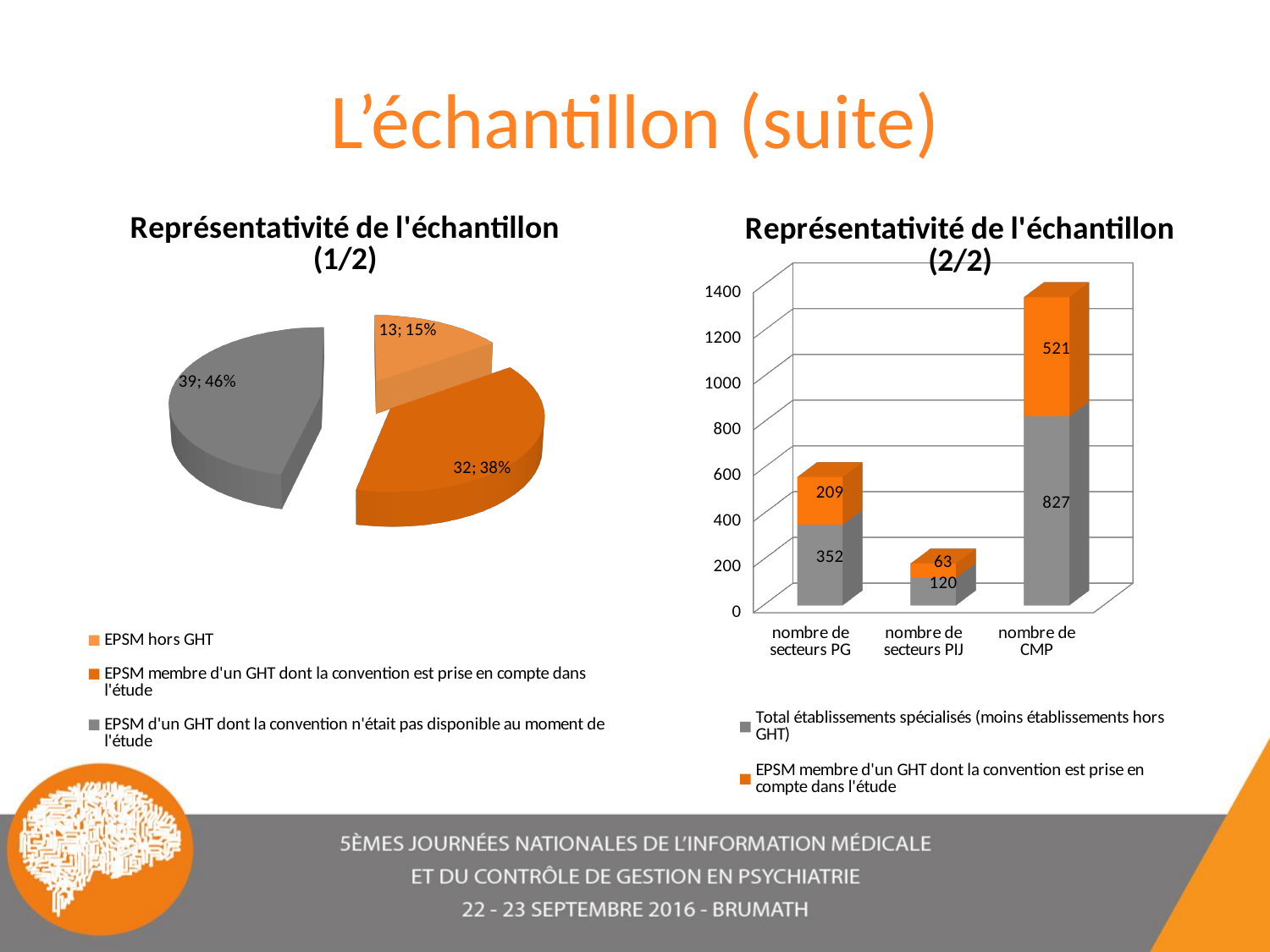
In the chart 'Représentativité de l'échantillon (1/2)', what share of the pie does the 'EPSM d'un GHT dont la convention n'était pas disponible au moment de l'étude' slice represent? 46% How many series does the legend of the chart 'Représentativité de l'échantillon (2/2)' list? 2 In the chart 'Représentativité de l'échantillon (2/2)', what is the value of 'Total établissements spécialisés (moins établissements hors GHT)' for 'nombre de secteurs PIJ'? 120 What kind of chart is 'Représentativité de l'échantillon (2/2)'? Stacked bar chart In the chart 'Représentativité de l'échantillon (1/2)', which category has the smallest slice? EPSM hors GHT In the chart 'Représentativité de l'échantillon (2/2)', what is the difference between the 'Total établissements spécialisés' value and the 'EPSM membre d'un GHT' value for 'nombre de CMP'? 306 In the chart 'Représentativité de l'échantillon (2/2)', what is the total of the stacked bar for 'nombre de secteurs PG'? 561 In the chart 'Représentativité de l'échantillon (1/2)', what value and share are shown for the 'EPSM hors GHT' slice? 13; 15% In the chart 'Représentativité de l'échantillon (2/2)', which category has the highest stacked total? nombre de CMP In the chart 'Représentativité de l'échantillon (2/2)', what is the value of 'EPSM membre d'un GHT dont la convention est prise en compte dans l'étude' for 'nombre de CMP'? 521 What kind of chart is 'Représentativité de l'échantillon (1/2)'? Pie chart In the chart 'Représentativité de l'échantillon (1/2)', which category has the largest slice? EPSM d'un GHT dont la convention n'était pas disponible au moment de l'étude